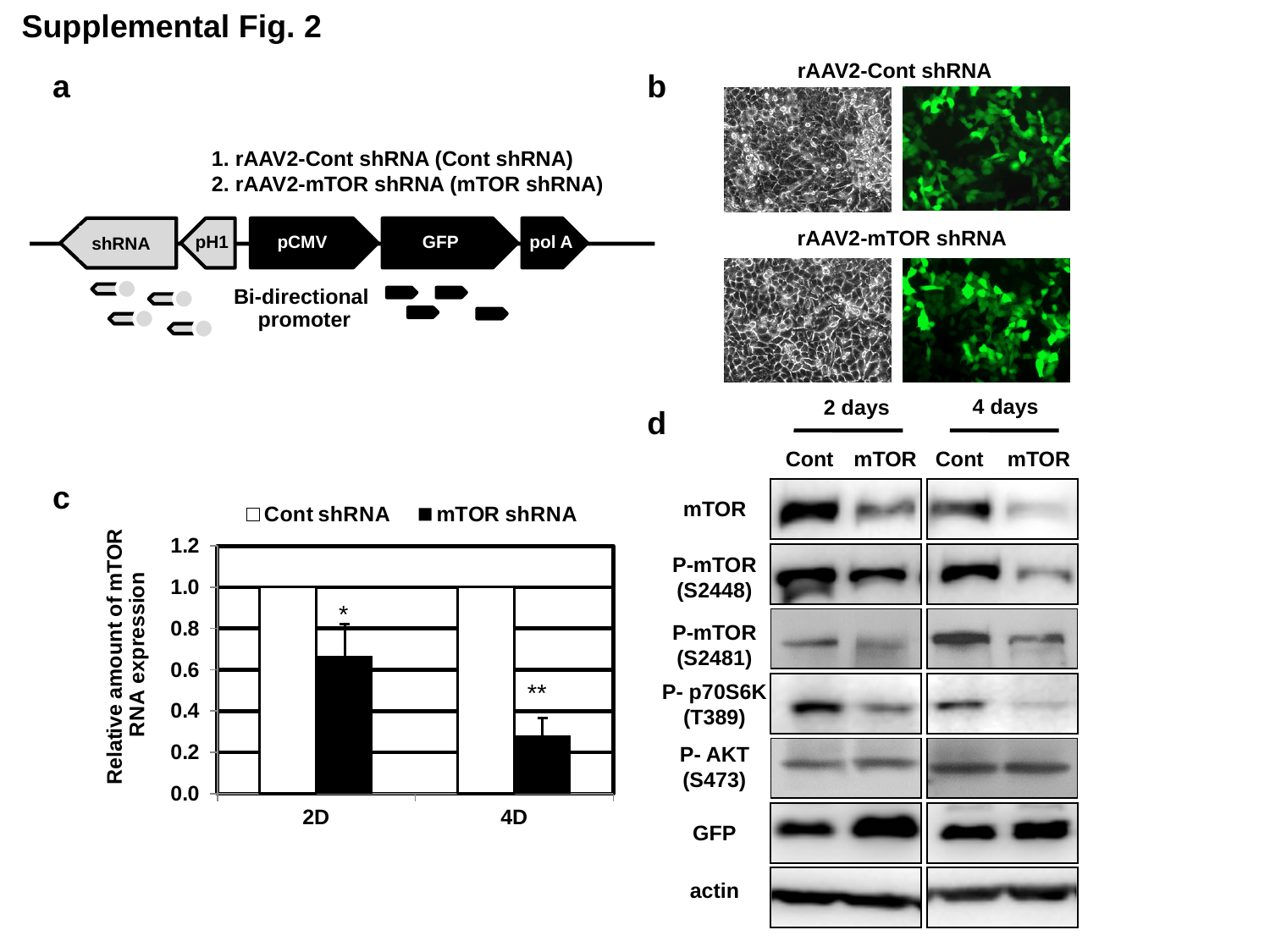
In the bar chart in panel c, what is the value for Cont shRNA at 4D? 1.0 In the bar chart in panel c, how many series does the legend list? 2 In the bar chart in panel c, is the value for mTOR shRNA at 2D greater or less than 0.6? greater In the bar chart in panel c, is the value for mTOR shRNA at 2D greater or less than 0.8? less In the bar chart in panel c, what is the label of the y axis? Relative amount of mTOR RNA expression In the bar chart in panel c, what is the value for Cont shRNA at 2D? 1.0 In the bar chart in panel c, does the mTOR shRNA value rise or fall from 2D to 4D? fall In the bar chart in panel c, which series has the larger value at 4D, Cont shRNA or mTOR shRNA? Cont shRNA In the bar chart in panel c, how many categories are shown on the x axis? 2 In the bar chart in panel c, what type of chart is shown? bar chart In the bar chart in panel c, is the value for mTOR shRNA at 4D greater or less than 0.4? less In the bar chart in panel c, which category has the lowest mTOR shRNA value? 4D